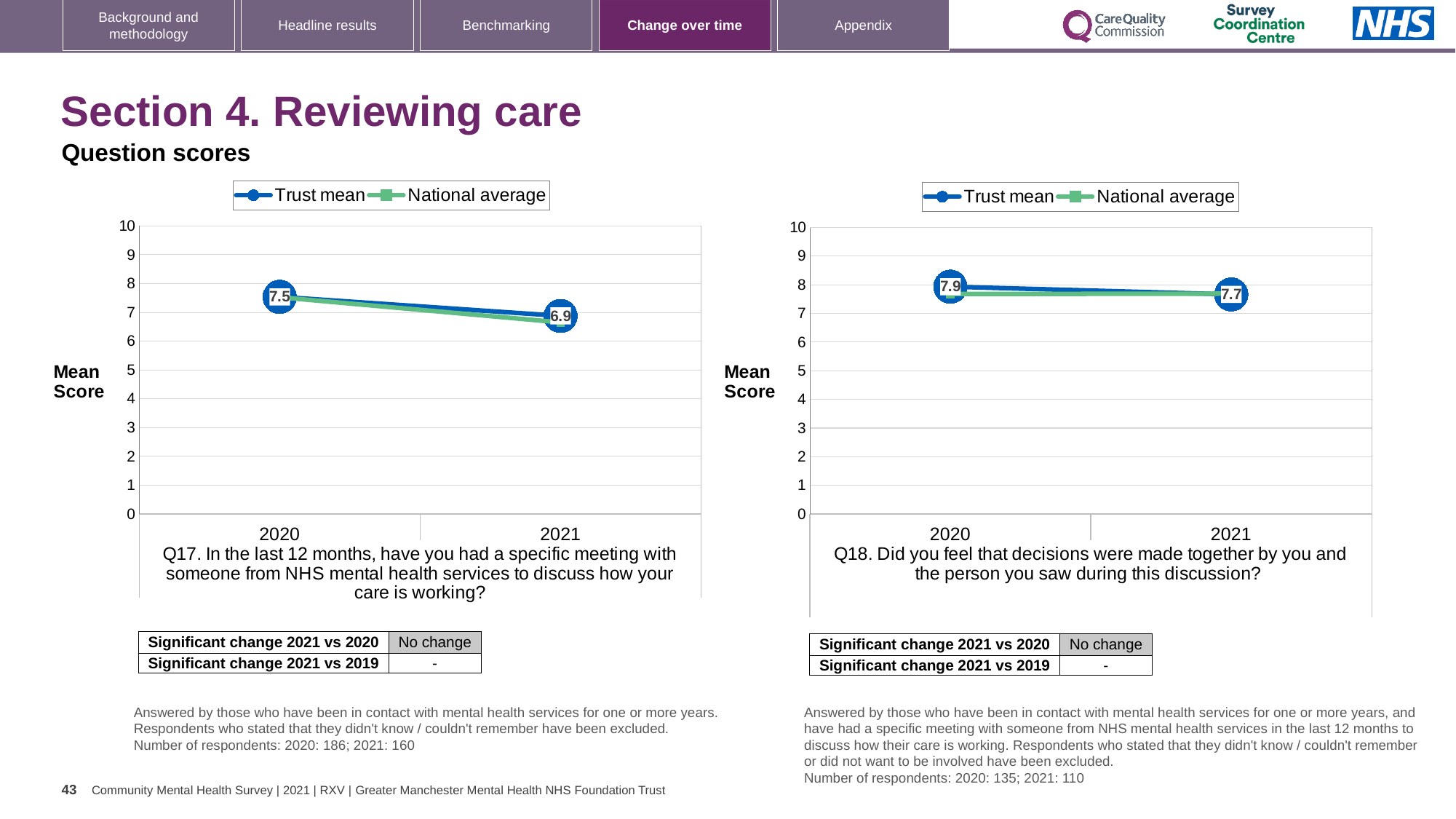
How many series does the legend of the Q18 chart on the right list? 2 In the Q17 chart on the left, what is the Trust mean score for 2020? 7.5 In the Q18 chart on the right, is the National average value for 2021 greater or less than 5? greater In the Q18 chart on the right, what is the Trust mean score for 2021? 7.7 In the Q17 chart on the left, which year has the higher Trust mean, 2020 or 2021? 2020 In the Q18 chart on the right, what is the Trust mean score for 2020? 7.9 In the Q17 chart on the left, by how much did the Trust mean fall from 2020 to 2021? 0.6 In the Q18 chart on the right, what is the difference between the Trust mean in 2020 and in 2021? 0.2 What kind of chart is the Q18 chart on the right? line chart In the Q17 chart on the left, what is the Trust mean score for 2021? 6.9 How many years are plotted on the x axis of the Q17 chart on the left? 2 In the Q17 chart on the left, does the Trust mean rise or fall from 2020 to 2021? fall